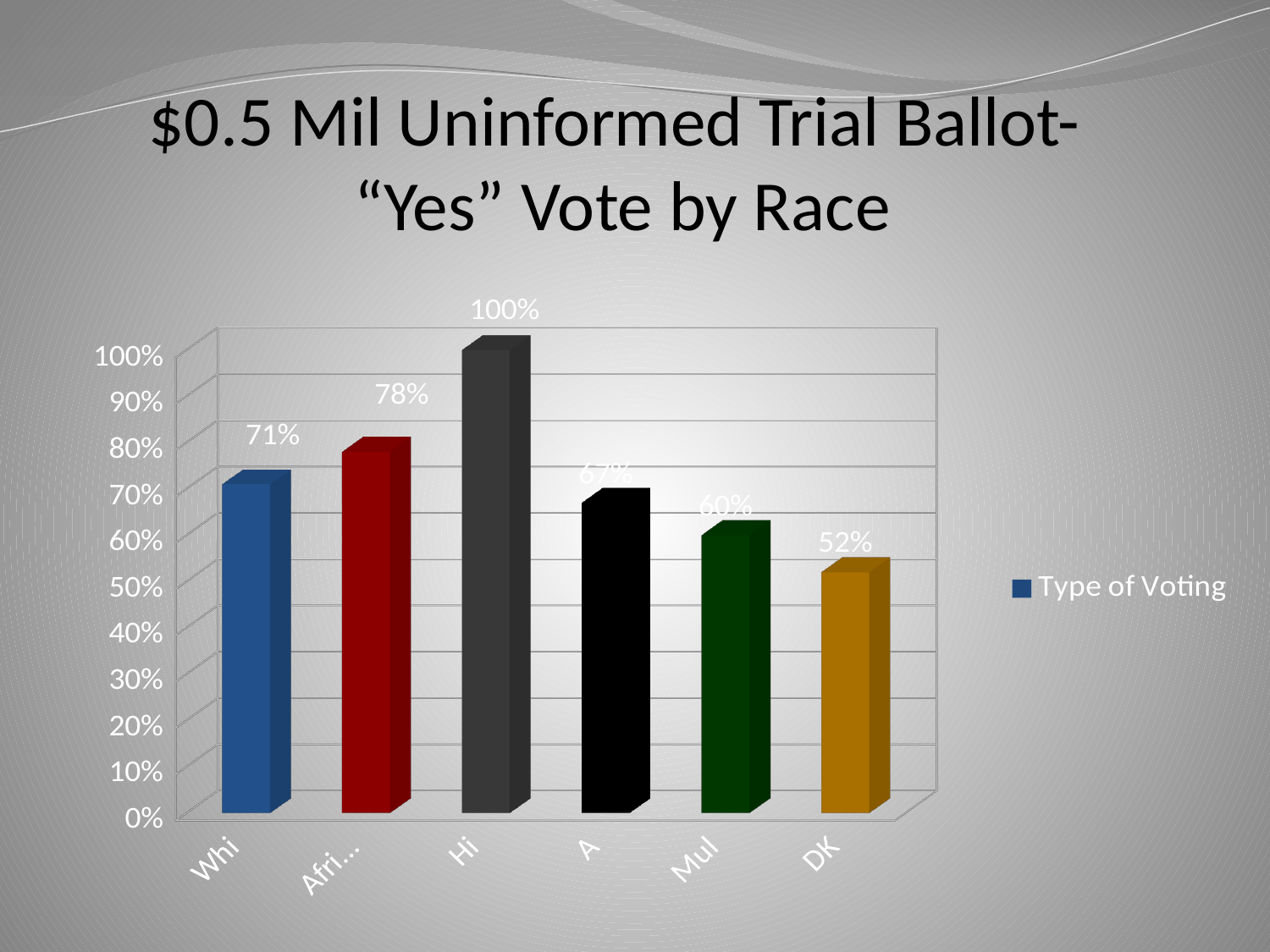
What is the difference between the values for "Hi" and "DK"? 48% What kind of chart is shown on the slide? Bar chart What is the value for the category labelled "DK"? 52% What is the value for the category labelled "Whi"? 71% Which category has the highest value? Hi What is the value for the category labelled "Hi"? 100% What is the value for the category labelled "Mul"? 60% What is the difference between the values for "Afri..." and "Whi"? 7% How many categories are shown on the x axis? 6 Which category has the lowest value? DK Which is larger, the value for "A" or the value for "Mul"? A What series name does the legend list? Type of Voting